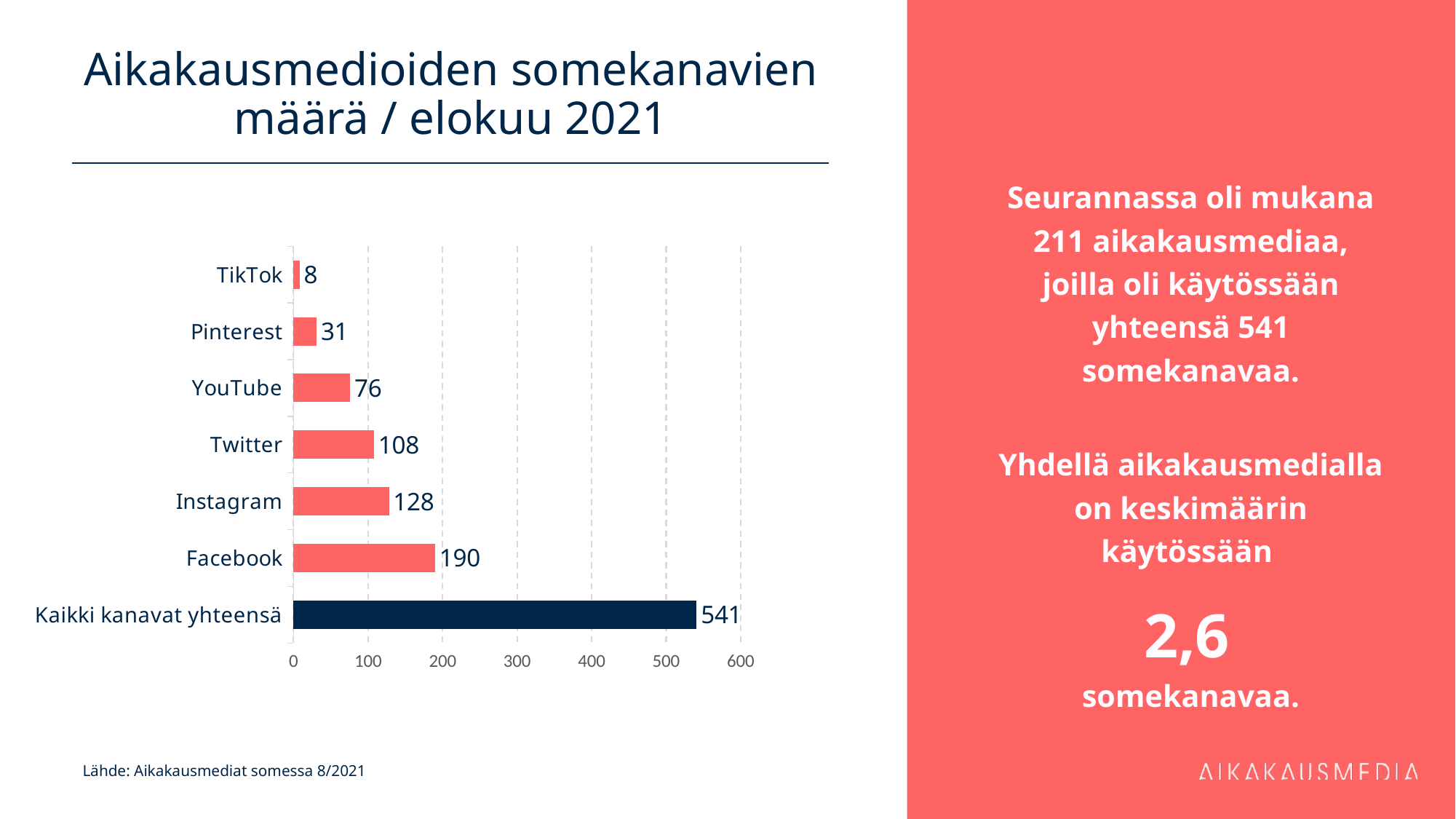
Which individual social media channel has the highest value? Facebook What is the title of the chart? Aikakausmedioiden somekanavien määrä / elokuu 2021 What is the value for TikTok? 8 What is the value for Facebook? 190 What kind of chart is shown on the slide? bar chart Which is larger, the value for Twitter or the value for YouTube? Twitter What is the value shown for Kaikki kanavat yhteensä? 541 How many categories are shown in the chart? 7 Is the value for Pinterest greater or less than 100? less What is the value for Instagram? 128 What is the difference between the values for Facebook and Instagram? 62 Which category has the lowest value? TikTok